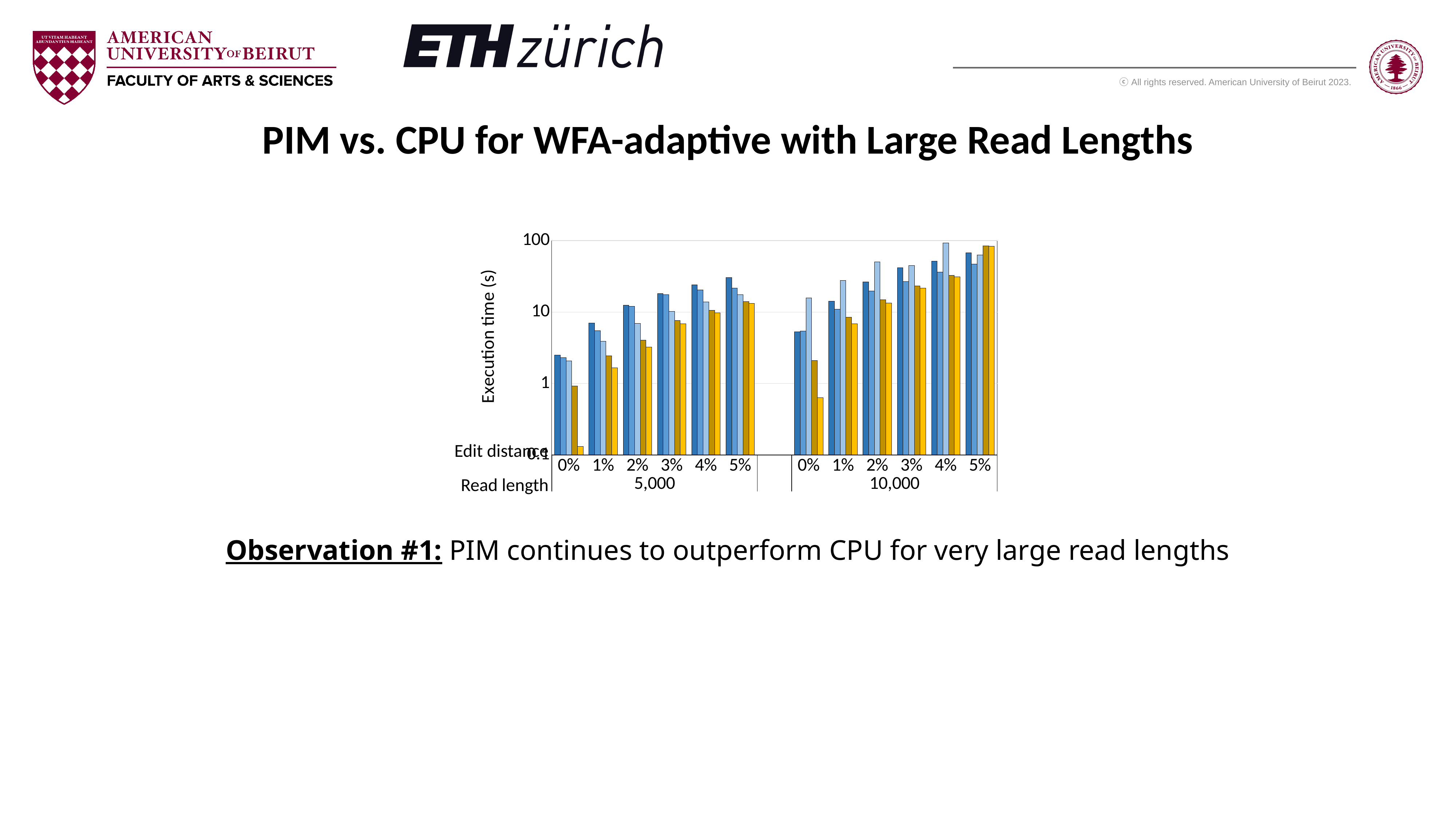
For read length 5,000, at which edit distance does the tallest bar occur? 5% How many read length groups are shown on the x-axis? 2 For read length 5,000, is the tallest bar at 1% edit distance greater or less than 10? less What is the label of the y-axis of the chart? Execution time (s) At 5% edit distance, which read length has the taller tallest bar, 5,000 or 10,000? 10,000 For read length 5,000, does the execution time of the dark blue bars rise or fall as edit distance increases from 0% to 5%? rise For read length 10,000 at 5% edit distance, are all the bars greater or less than 10? greater What kind of chart is shown on the slide? Bar chart For read length 10,000, is the shortest bar at 0% edit distance greater or less than 1? less What is the highest tick value shown on the y-axis? 100 How many edit distance categories are shown for each read length? 6